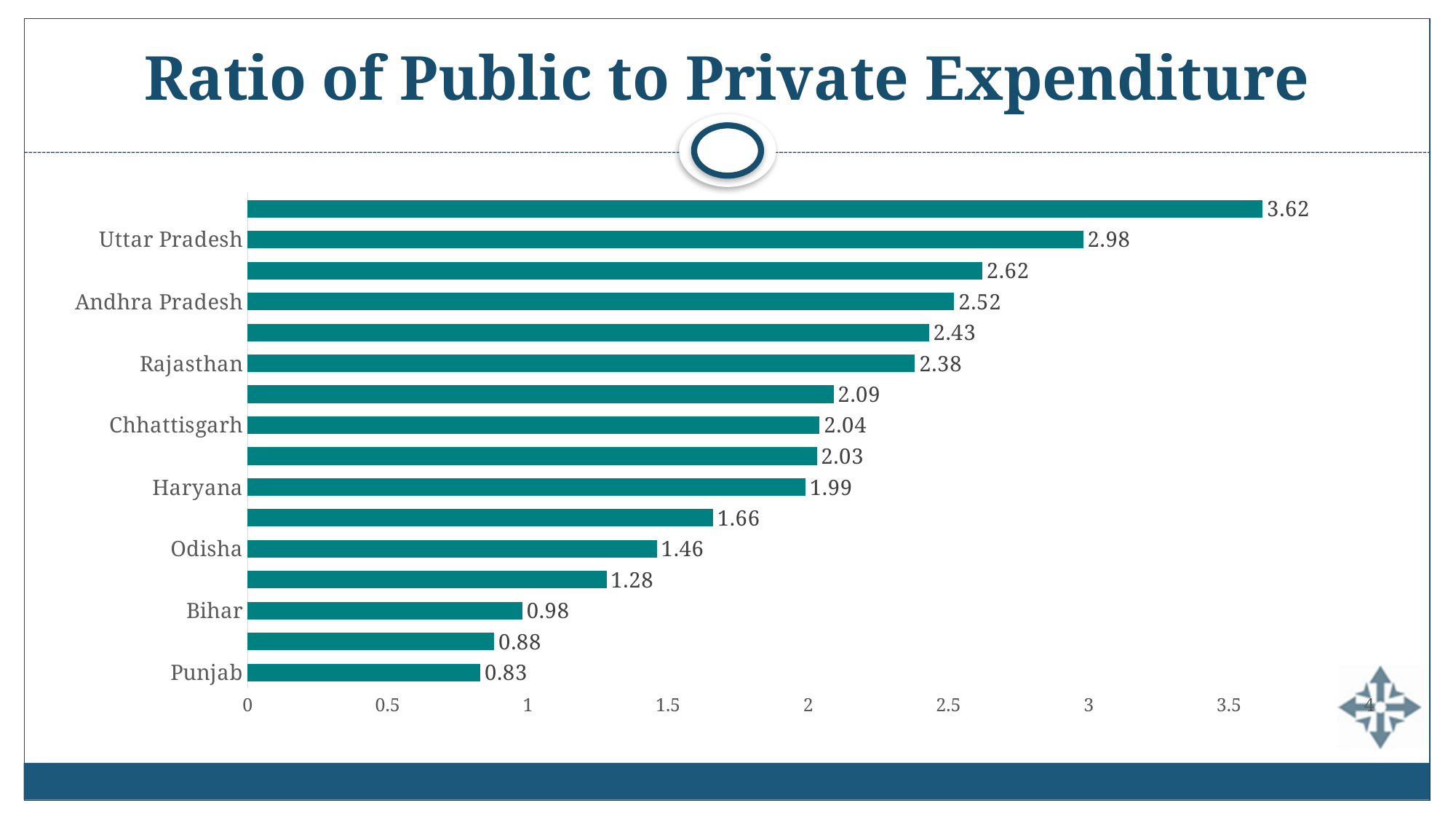
What is the value shown for Rajasthan? 2.38 Which has a larger value, Rajasthan or Haryana? Rajasthan What is the highest value printed on the chart? 3.62 How many bars are plotted on the chart? 16 What is the difference between the values for Uttar Pradesh and Bihar? 2.00 What is the value shown for Chhattisgarh? 2.04 What is the value shown for Bihar? 0.98 What is the value shown for Haryana? 1.99 What is the value shown for Odisha? 1.46 What is the ratio of public to private expenditure for Uttar Pradesh? 2.98 What is the value shown for Andhra Pradesh? 2.52 Which labelled state has the lowest ratio of public to private expenditure? Punjab